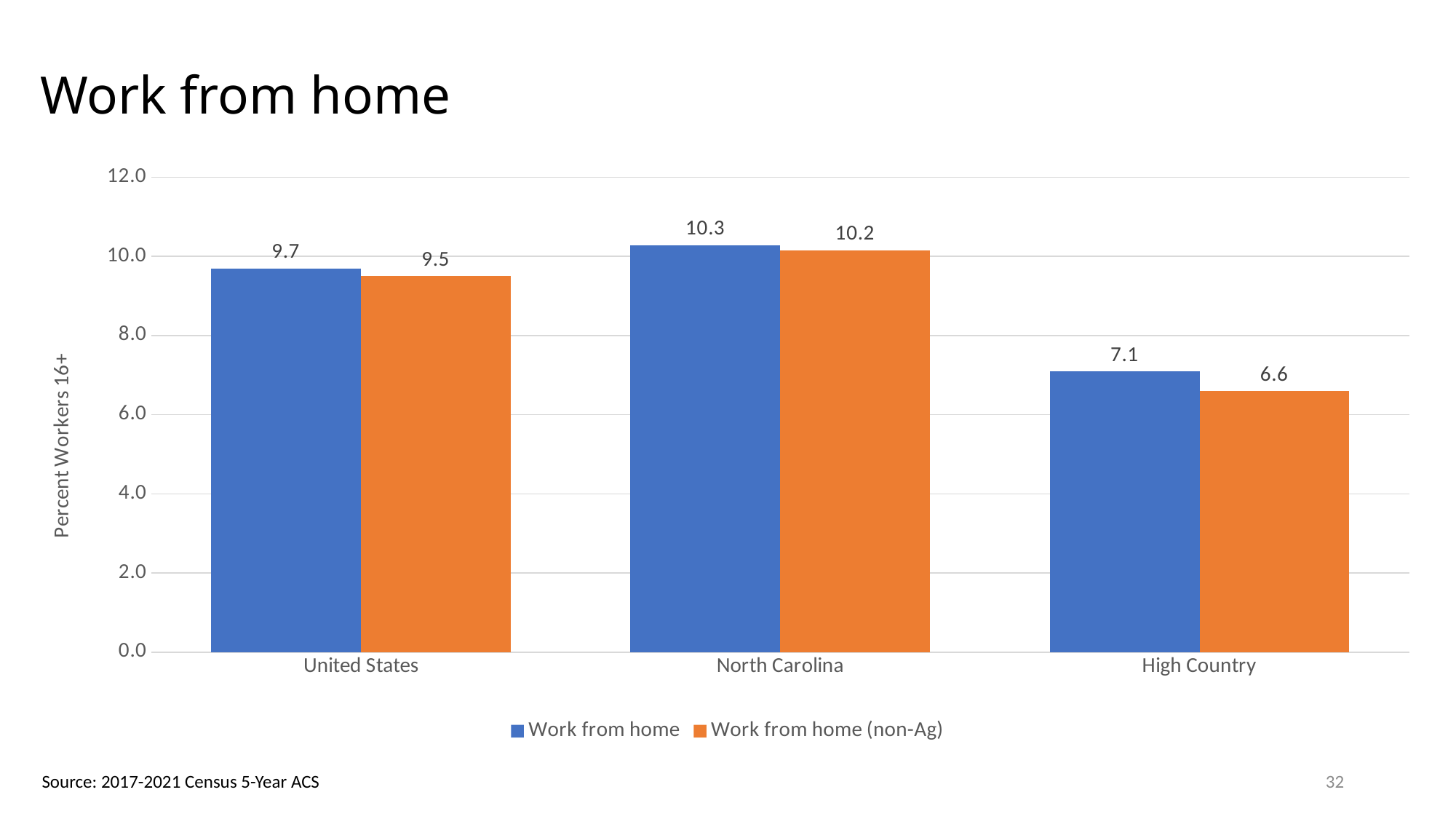
What is the Work from home value for North Carolina? 10.3 How many series does the legend list? 2 Which category has the highest Work from home value? North Carolina Is the Work from home (non-Ag) value for North Carolina greater or less than 8.0? greater What kind of chart is shown on the slide? Bar chart How many categories are shown on the x axis? 3 Which category has the lowest Work from home (non-Ag) value? High Country What is the Work from home (non-Ag) value for High Country? 6.6 What is the Work from home value for the United States? 9.7 Which is larger, the Work from home value for the United States or for High Country? United States What is the difference between the Work from home and Work from home (non-Ag) values for the United States? 0.2 What is the difference between the Work from home values for North Carolina and High Country? 3.2